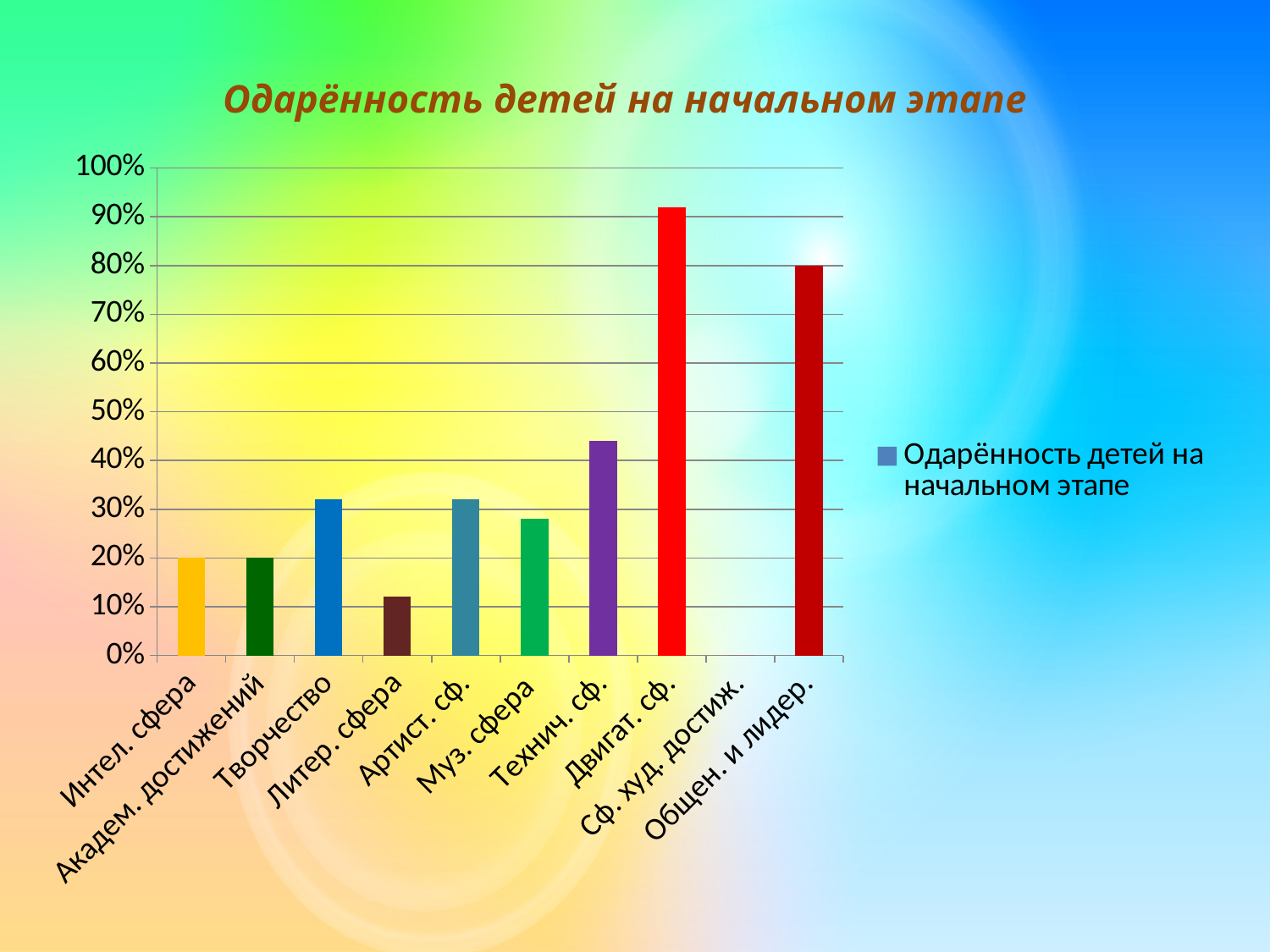
What is the value for Общен. и лидер.? 80% Is the value for Технич. сф. greater or less than 40%? greater Which category has the highest value? Двигат. сф. How many series does the legend list? 1 What type of chart is shown on the slide? bar chart Which category has the shortest visible bar? Литер. сфера Is the value for Литер. сфера greater or less than 20%? less What is the value for Интел. сфера? 20% How many categories are shown on the x axis of the chart? 10 Which is larger, the value for Технич. сф. or the value for Муз. сфера? Технич. сф. Is the value for Двигат. сф. greater or less than 90%? greater What is the title of the chart? Одарённость детей на начальном этапе